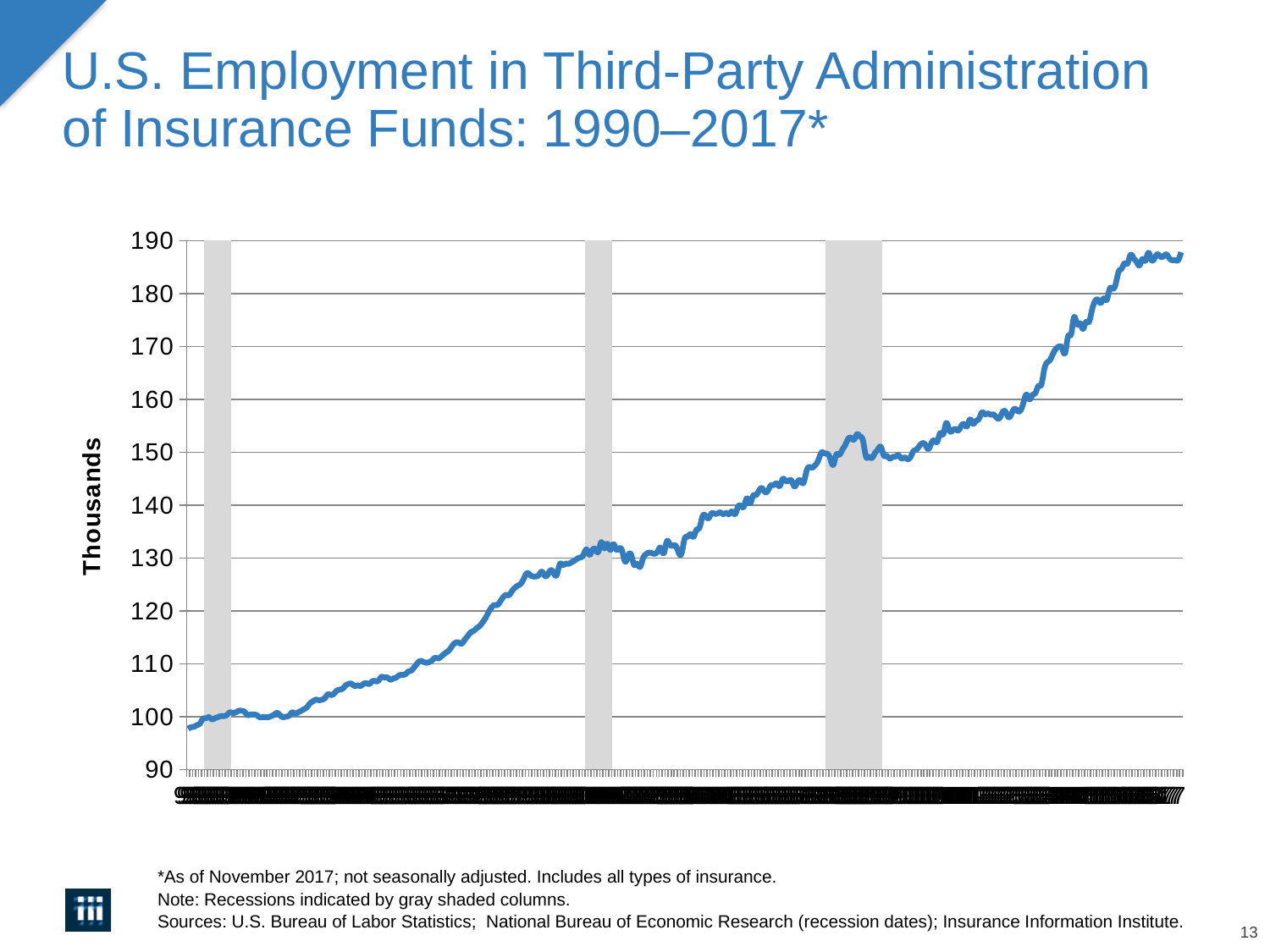
Is the highest point of the line greater or less than 170? greater Is the value of the line at the start of the second gray shaded recession column greater or less than 120? greater How many gray shaded recession columns appear on the chart? 3 Is the value at the right end of the line (late 2017) greater or less than 180? greater What is the label on the vertical axis of the chart? Thousands Overall, do the values rise or fall from left to right along the x axis? rise What kind of chart is shown on the slide? line chart